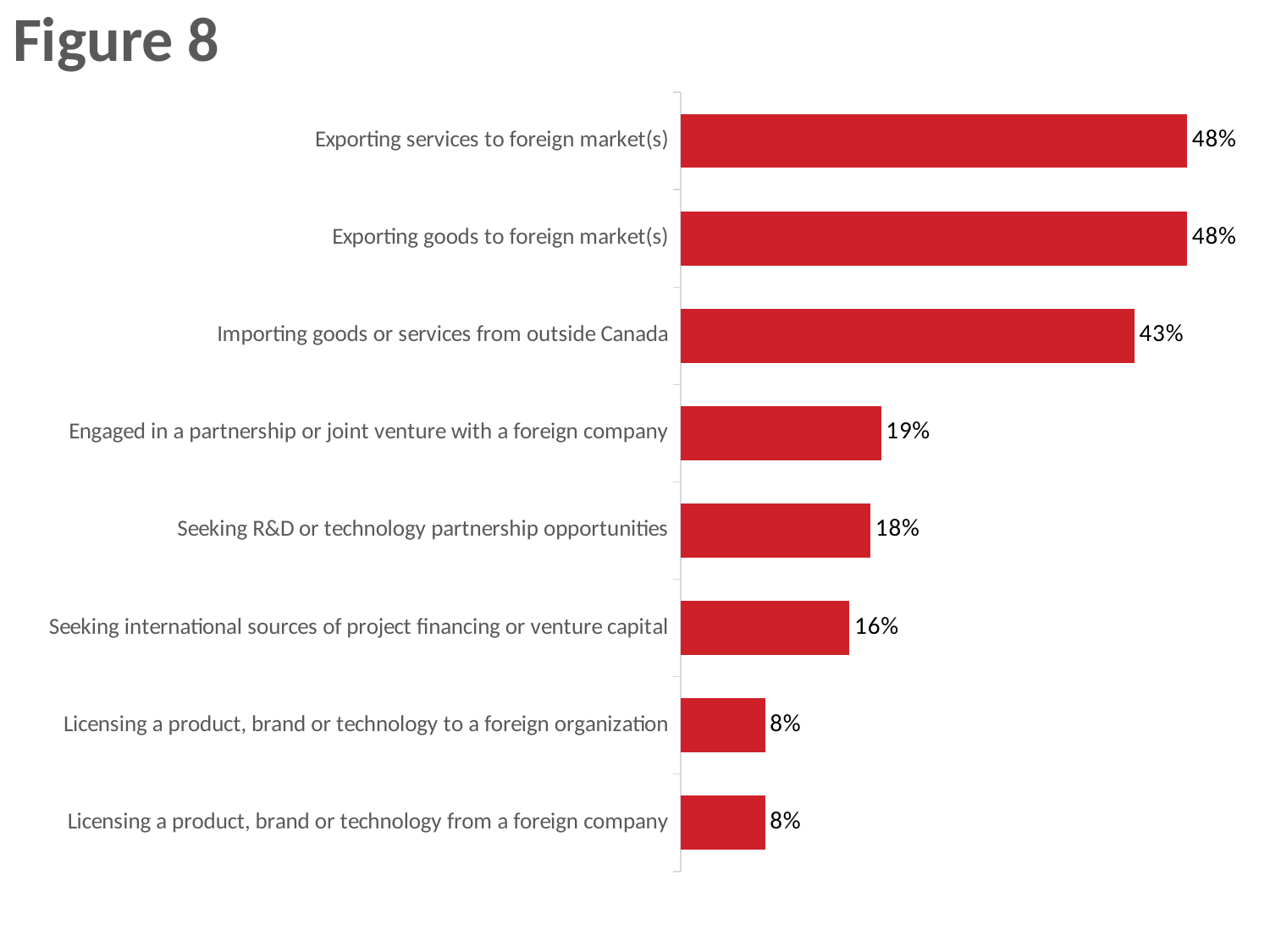
Which is larger: 'Seeking R&D or technology partnership opportunities' or 'Seeking international sources of project financing or venture capital'? Seeking R&D or technology partnership opportunities What is the value for 'Engaged in a partnership or joint venture with a foreign company'? 19% What is the difference between 'Exporting goods to foreign market(s)' and 'Importing goods or services from outside Canada'? 5% What is the value for 'Seeking R&D or technology partnership opportunities'? 18% How many categories are shown in the chart? 8 Which is larger: 'Importing goods or services from outside Canada' or 'Engaged in a partnership or joint venture with a foreign company'? Importing goods or services from outside Canada What is the value for 'Importing goods or services from outside Canada'? 43% What is the value for 'Licensing a product, brand or technology to a foreign organization'? 8% What is the title shown on the slide? Figure 8 What is the difference between 'Engaged in a partnership or joint venture with a foreign company' and 'Licensing a product, brand or technology from a foreign company'? 11% What is the value for 'Seeking international sources of project financing or venture capital'? 16% What kind of chart is shown on the slide? Bar chart